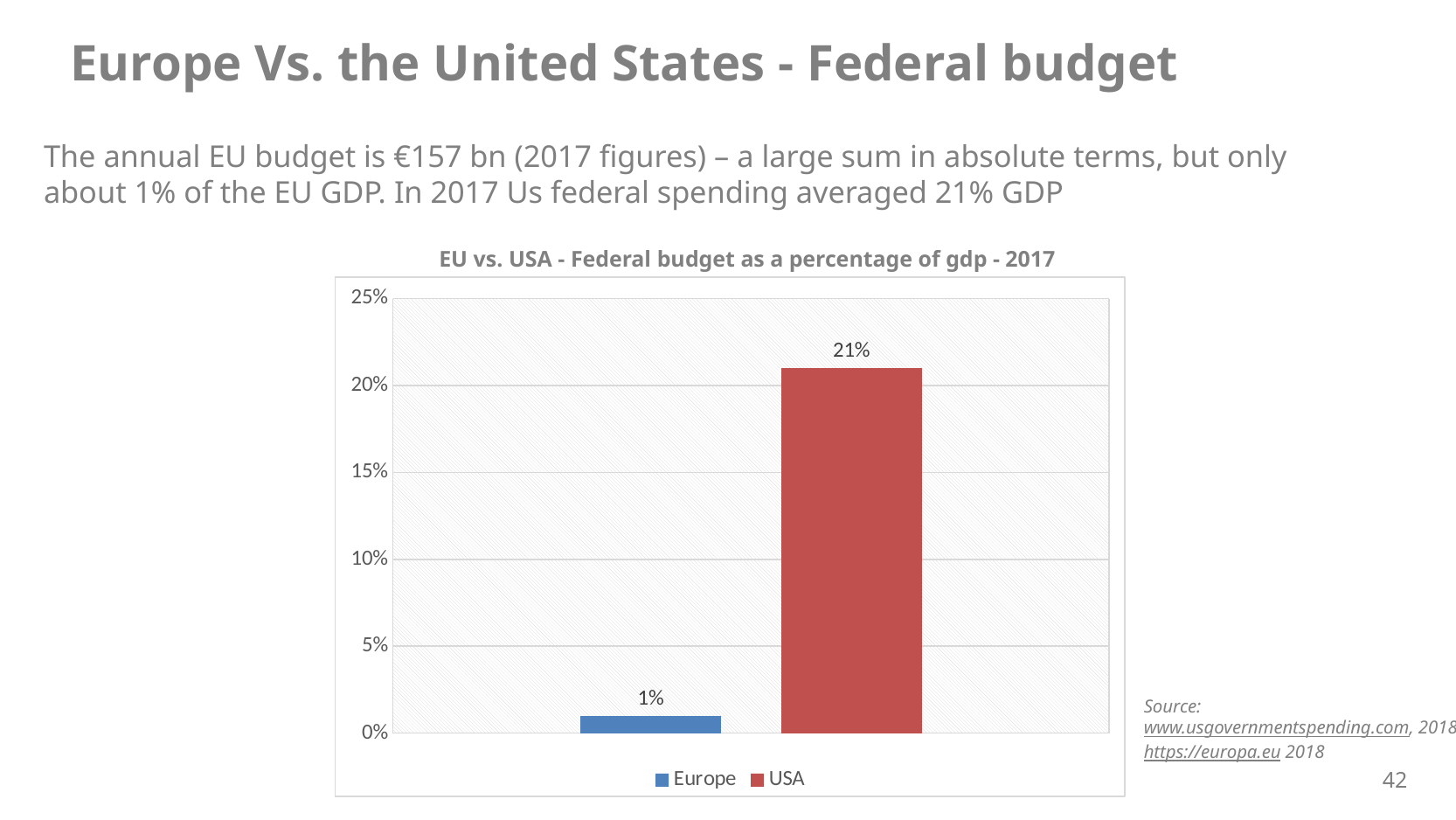
Is the value for USA larger or smaller than the value for Europe? larger Is the value for USA greater or less than 20%? greater Is the value for Europe greater or less than 5%? less How many bars are plotted in the chart? 2 What is the difference between the USA value and the Europe value? 20% Which has the higher federal budget as a percentage of GDP, Europe or USA? USA What is the value for Europe in the chart? 1% Which has the lower federal budget as a percentage of GDP, Europe or USA? Europe What is the title of the chart? EU vs. USA - Federal budget as a percentage of gdp - 2017 How many series does the legend list? 2 What is the value for USA in the chart? 21% What kind of chart is shown on the slide? bar chart